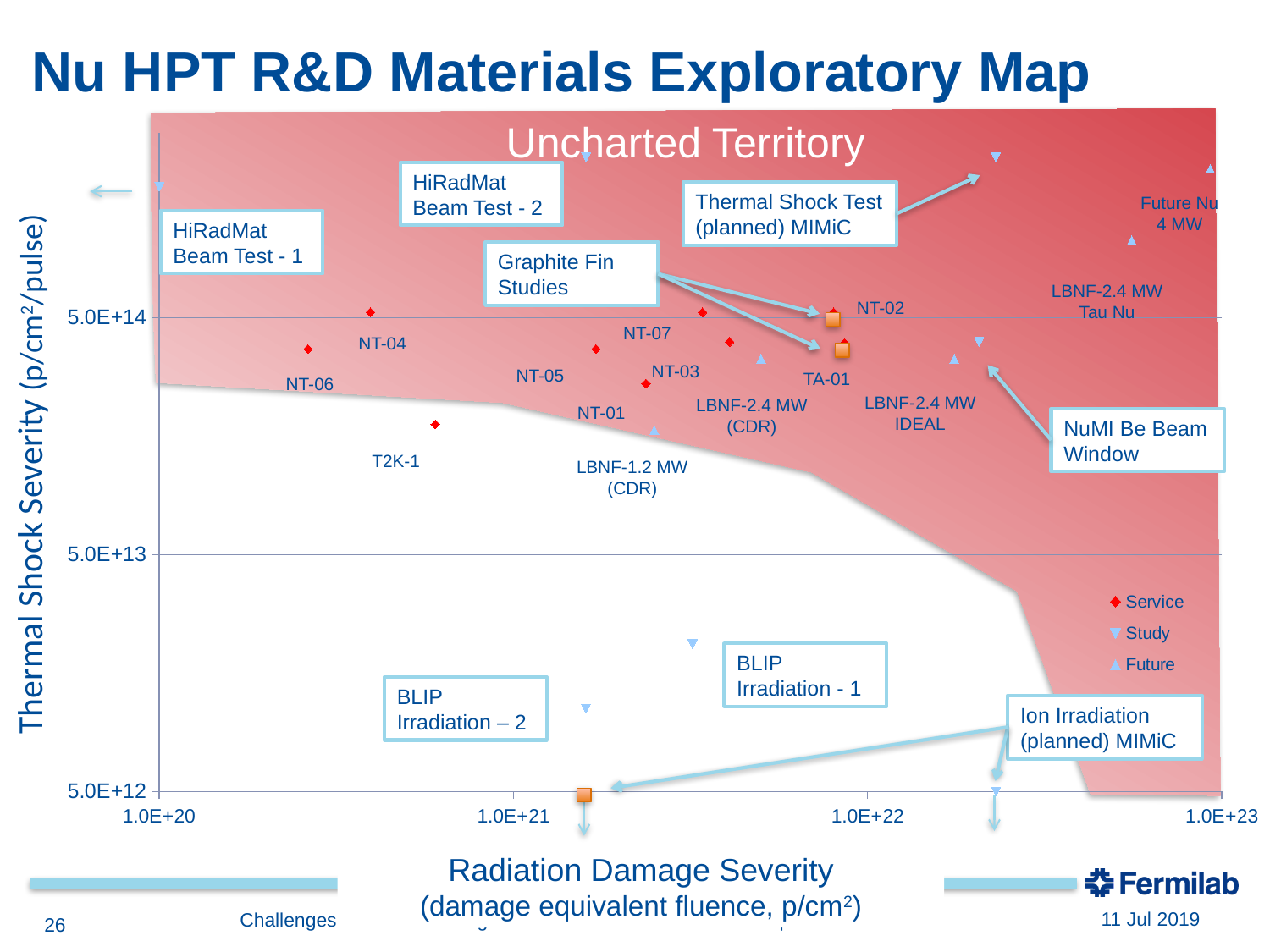
Which has the higher thermal shock severity, NT-06 or T2K-1? NT-06 Is the thermal shock severity for BLIP Irradiation - 1 greater or less than 5.0E+13? less Is the thermal shock severity for T2K-1 greater or less than 5.0E+14? less Which labeled point has the lowest thermal shock severity? Ion Irradiation (planned) MIMiC What is the label of the y axis? Thermal Shock Severity (p/cm²/pulse) What are the three series named in the legend? Service, Study, Future How many series does the legend list? 3 What kind of chart is shown on the slide? scatter chart Is the thermal shock severity for LBNF-1.2 MW (CDR) greater or less than 5.0E+14? less Which has the higher radiation damage severity, T2K-1 or NT-01? NT-01 Which labeled point has the highest radiation damage severity? Future Nu 4 MW